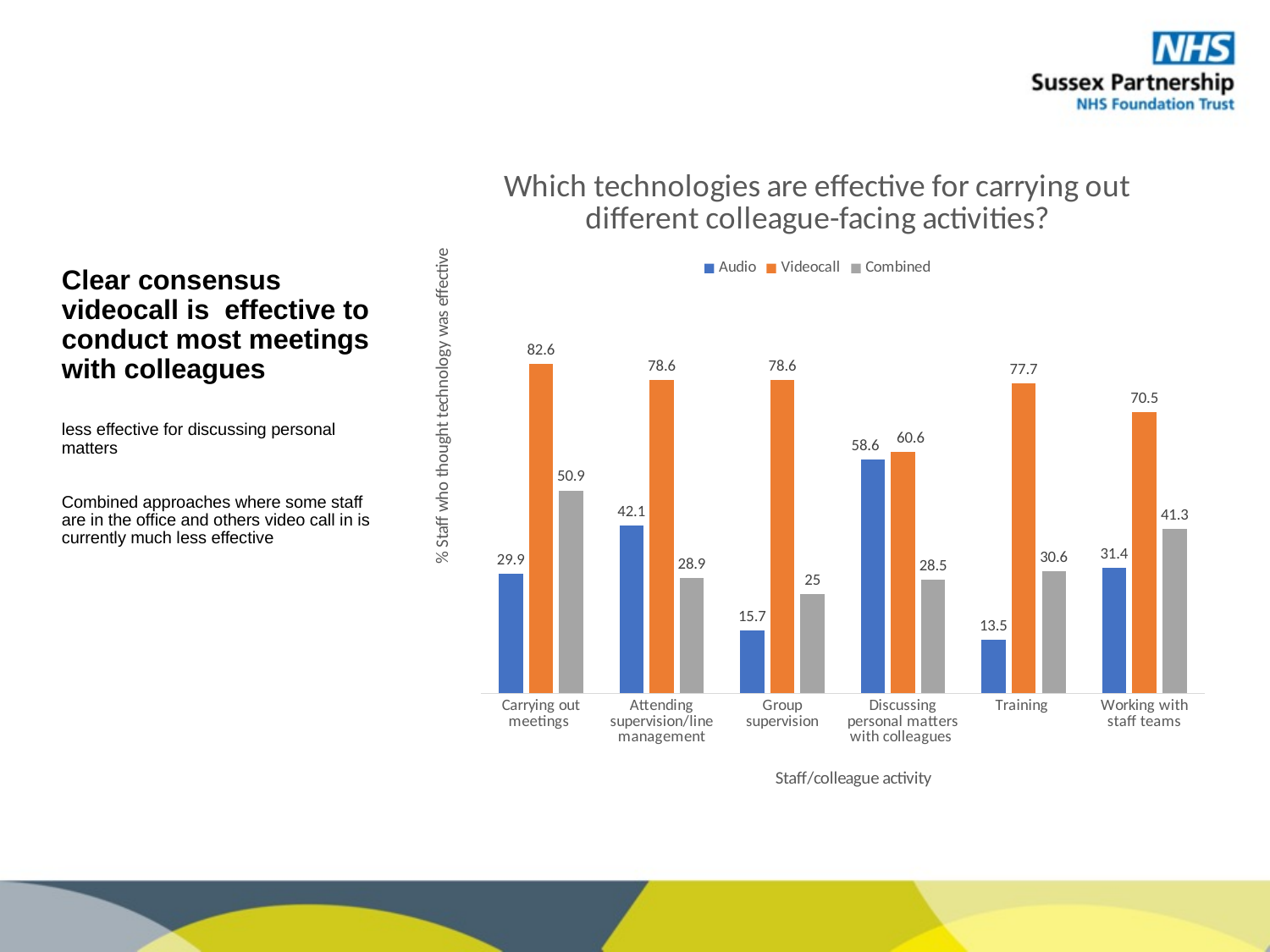
How many series does the legend list? 3 For Discussing personal matters with colleagues, which is larger: the Audio value or the Videocall value? Videocall Which activity has the highest Videocall value? Carrying out meetings What is the Videocall value for Carrying out meetings? 82.6 What is the difference between the Videocall and Audio values for Group supervision? 62.9 Which activity has the lowest Audio value? Training What kind of chart is shown on the slide? Bar chart What is the Audio value for Training? 13.5 What is the title of the chart? Which technologies are effective for carrying out different colleague-facing activities? What is the label of the x axis? Staff/colleague activity What is the Combined value for Working with staff teams? 41.3 How many activity categories are shown on the x axis? 6